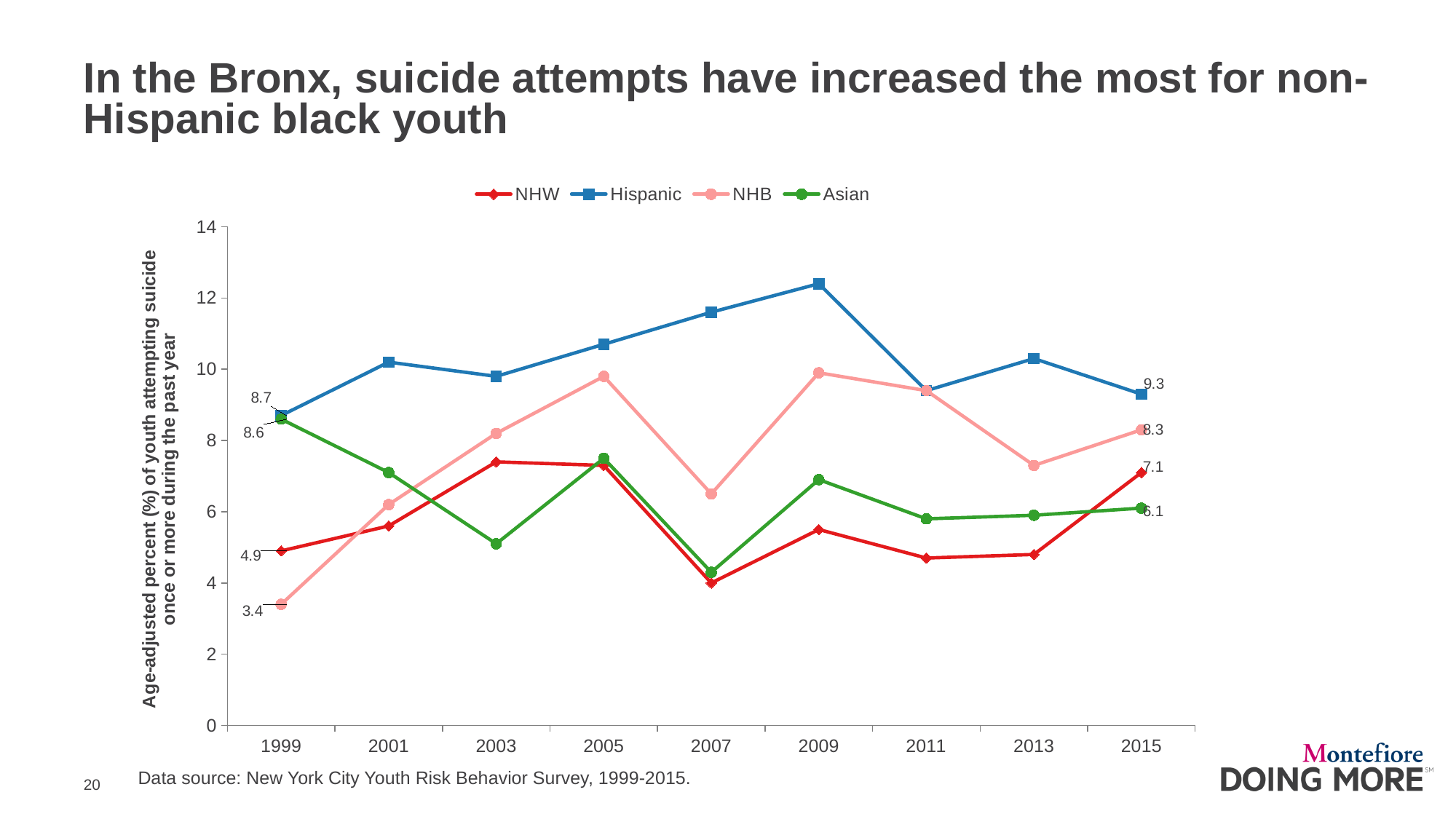
What is the value for NHB in 1999? 3.4 What is the value for NHW in 1999? 4.9 How many years are shown on the x axis? 9 Is the value for Hispanic in 2009 greater or less than 12? greater Which series has the highest value in 2015? Hispanic Which series has the lowest value in 1999? NHB What is the value for Asian in 2015? 6.1 What is the value for Hispanic in 2015? 9.3 Which is larger in 2015, the value for NHW or the value for Asian? NHW How many series does the legend list? 4 What type of chart is shown on the slide? line chart By how much did the NHB value change from 1999 to 2015? 4.9